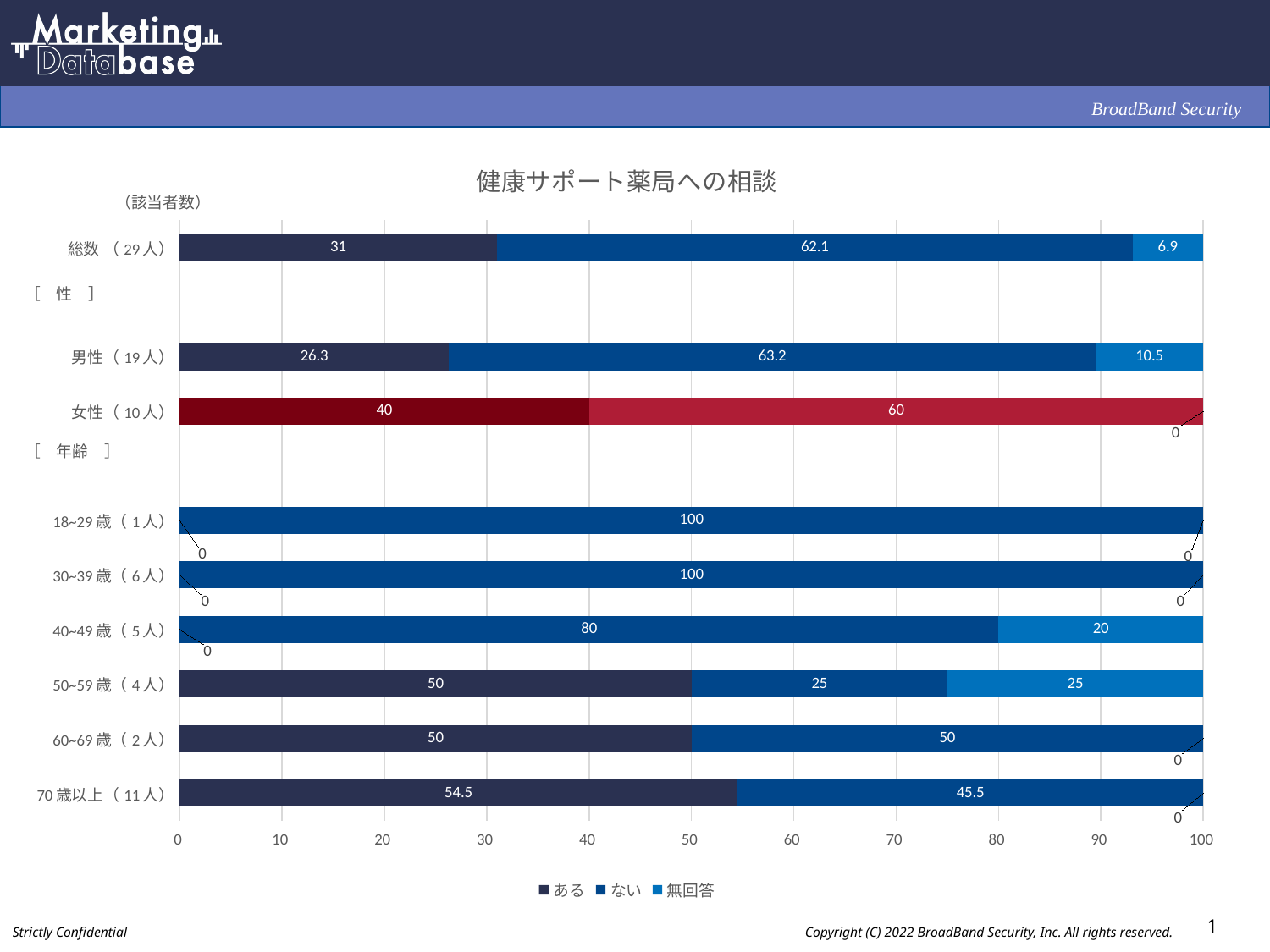
What is the value of ない for 70歳以上 (11人)? 45.5 What kind of chart is shown on the slide? Stacked bar chart What is the value of 無回答 for 男性 (19人)? 10.5 What is the value of 無回答 for 40~49歳 (5人)? 20 How many series does the legend list? 3 What is the total of the stacked bar for 50~59歳 (4人)? 100 What is the difference between the ない values for 男性 (19人) and 女性 (10人)? 3.2 What is the value of ない for 総数 (29人)? 62.1 What is the title of the chart? 健康サポート薬局への相談 What is the value of ある for 女性 (10人)? 40 Which is larger, the ある value for 総数 (29人) or for 男性 (19人)? 総数 (29人) Which category has the highest value for ある? 70歳以上 (11人)